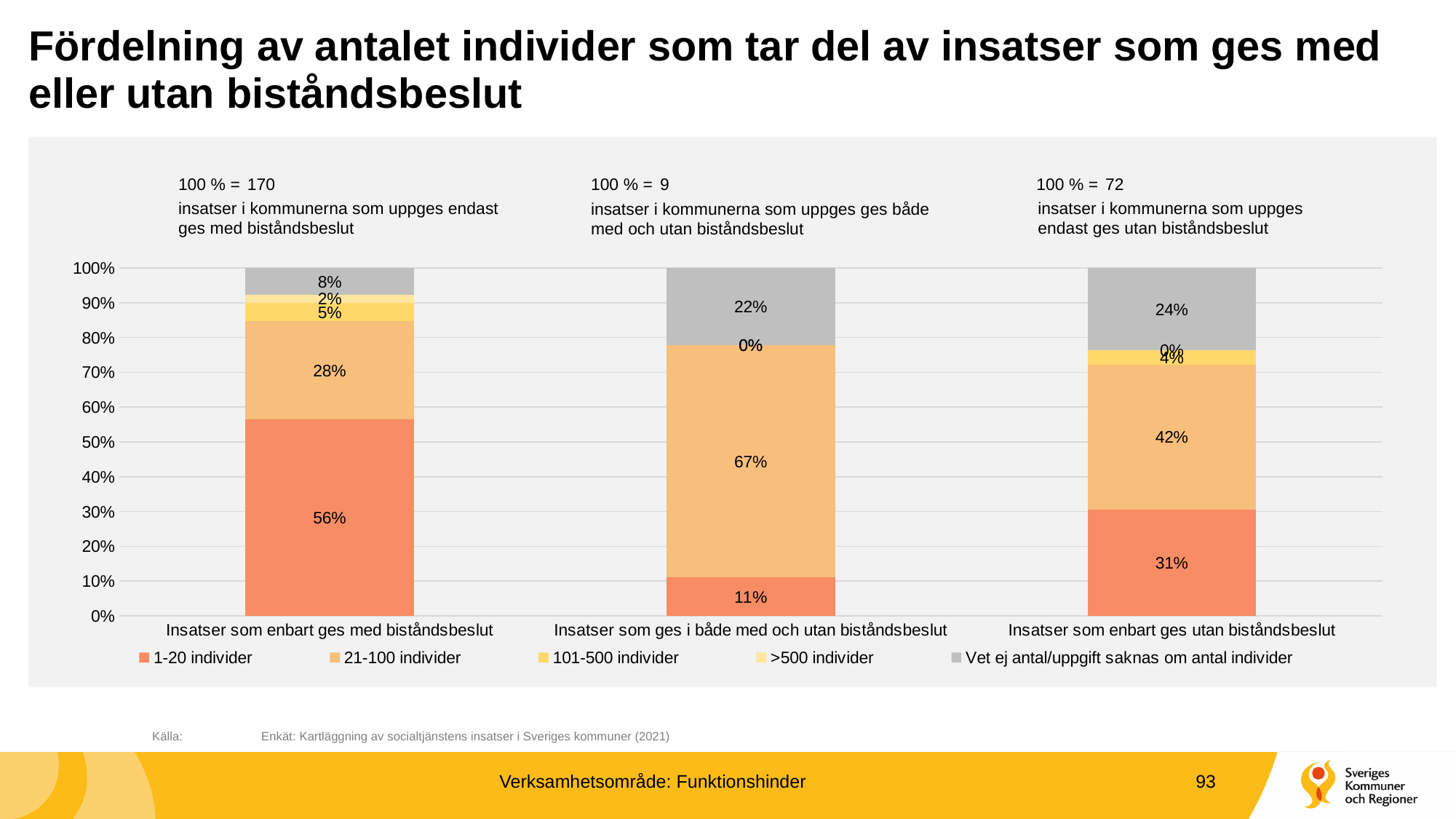
What is the 'Vet ej antal/uppgift saknas om antal individer' share for 'Insatser som enbart ges utan biståndsbeslut'? 24% According to the note above the first bar, how many insatser does 100 % correspond to for 'insatser i kommunerna som uppges endast ges med biståndsbeslut'? 170 Which has a larger 'Vet ej antal/uppgift saknas om antal individer' share: 'Insatser som enbart ges med biståndsbeslut' or 'Insatser som ges i både med och utan biståndsbeslut'? Insatser som ges i både med och utan biståndsbeslut What kind of chart is shown on the slide? Stacked bar chart What is the '101-500 individer' share for 'Insatser som enbart ges med biståndsbeslut'? 5% Which category has the smallest '21-100 individer' share? Insatser som enbart ges med biståndsbeslut What is the '21-100 individer' share for 'Insatser som ges i både med och utan biståndsbeslut'? 67% How many series does the legend list? 5 What percentage of 'Insatser som enbart ges med biståndsbeslut' falls in the '1-20 individer' segment? 56% What is the difference in the '21-100 individer' share between 'Insatser som ges i både med och utan biståndsbeslut' and 'Insatser som enbart ges utan biståndsbeslut'? 25 percentage points How many categories are shown on the x axis of the chart? 3 Which category has the largest '1-20 individer' share? Insatser som enbart ges med biståndsbeslut